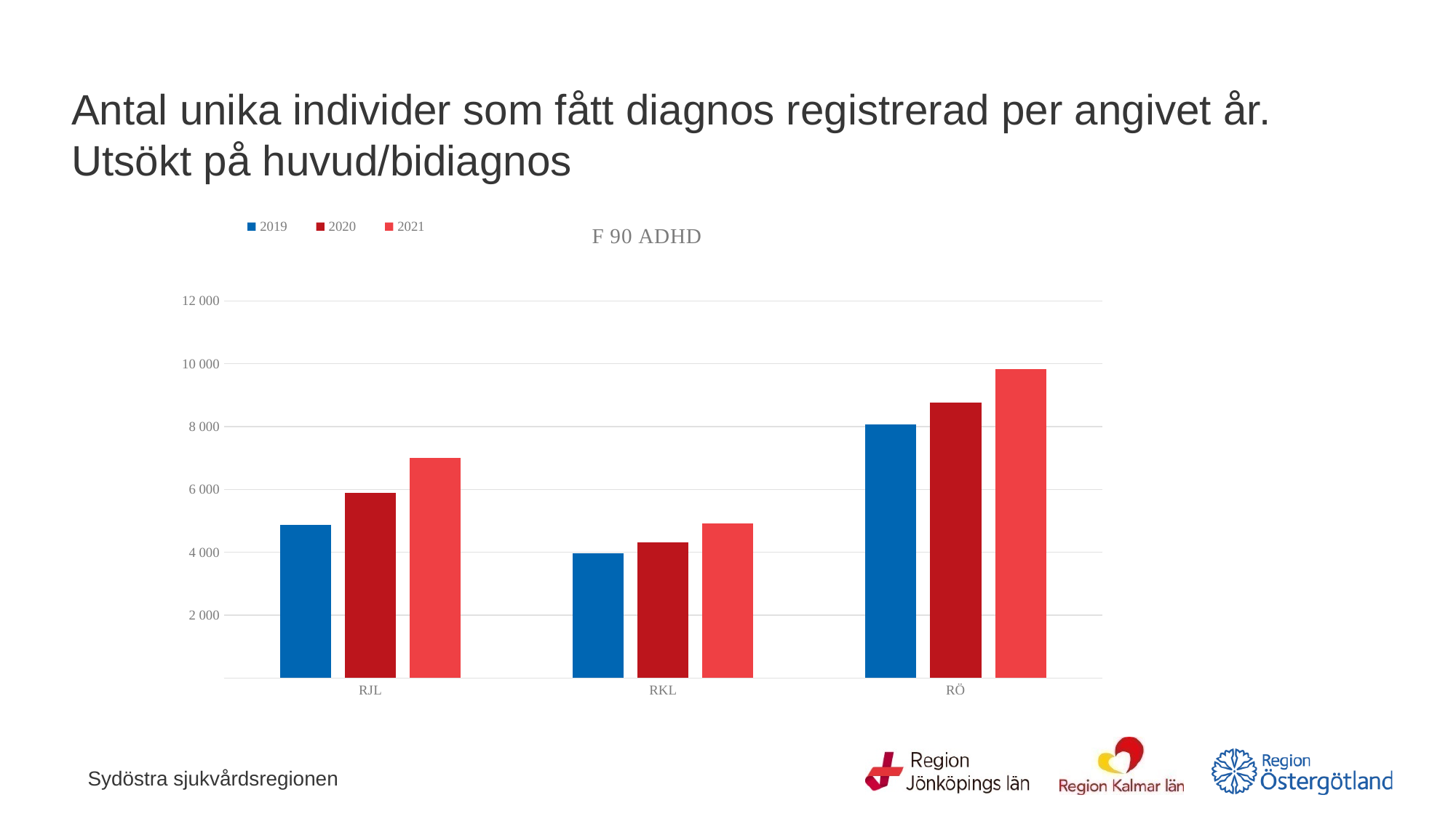
Is the value for RÖ in 2021 greater or less than 8 000? greater Which is larger for RJL: the value for 2019 or the value for 2021? 2021 What is the title of the chart? F 90 ADHD Which category has the lowest value for 2019? RKL Which category has the highest value for 2021? RÖ Is the value for RKL in 2021 greater or less than 6 000? less How many series does the legend list? 3 How many categories are shown on the x axis? 3 What type of chart is shown on the slide? bar chart Is the value for RJL in 2021 greater or less than 6 000? greater For RÖ, do the values rise or fall from 2019 to 2021? rise